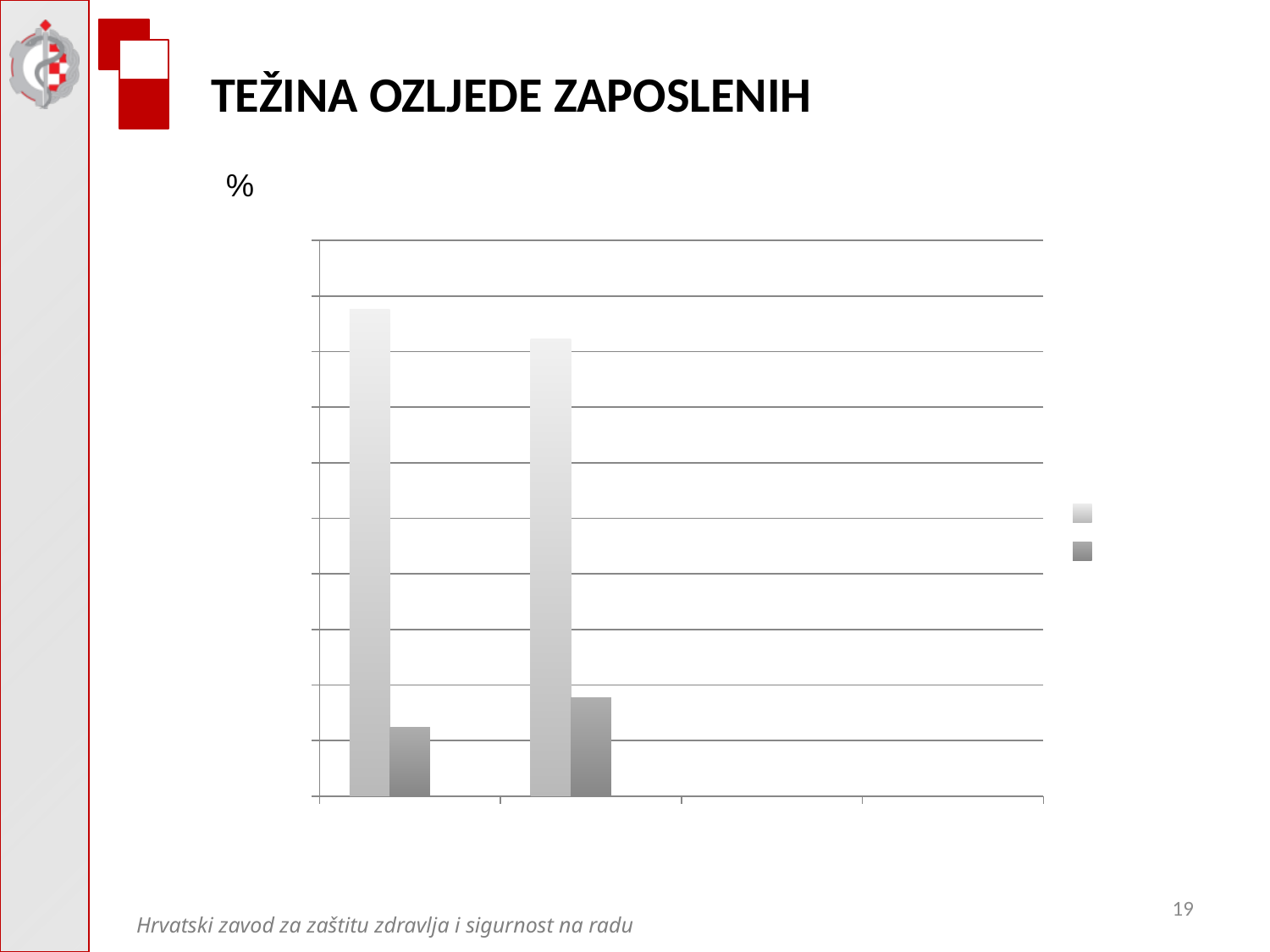
What kind of chart is shown on the slide? bar chart Is the lighter bar taller in the left group or in the right group? the left group In the leftmost group of bars, is the lighter bar or the darker bar taller? the lighter bar What is the title of the slide containing the chart? TEŽINA OZLJEDE ZAPOSLENIH How many groups of bars are plotted on the chart? 2 What unit symbol is shown above the chart's vertical axis? % Is the darker bar taller in the left group or in the right group? the right group How many series does the chart's legend list? 2